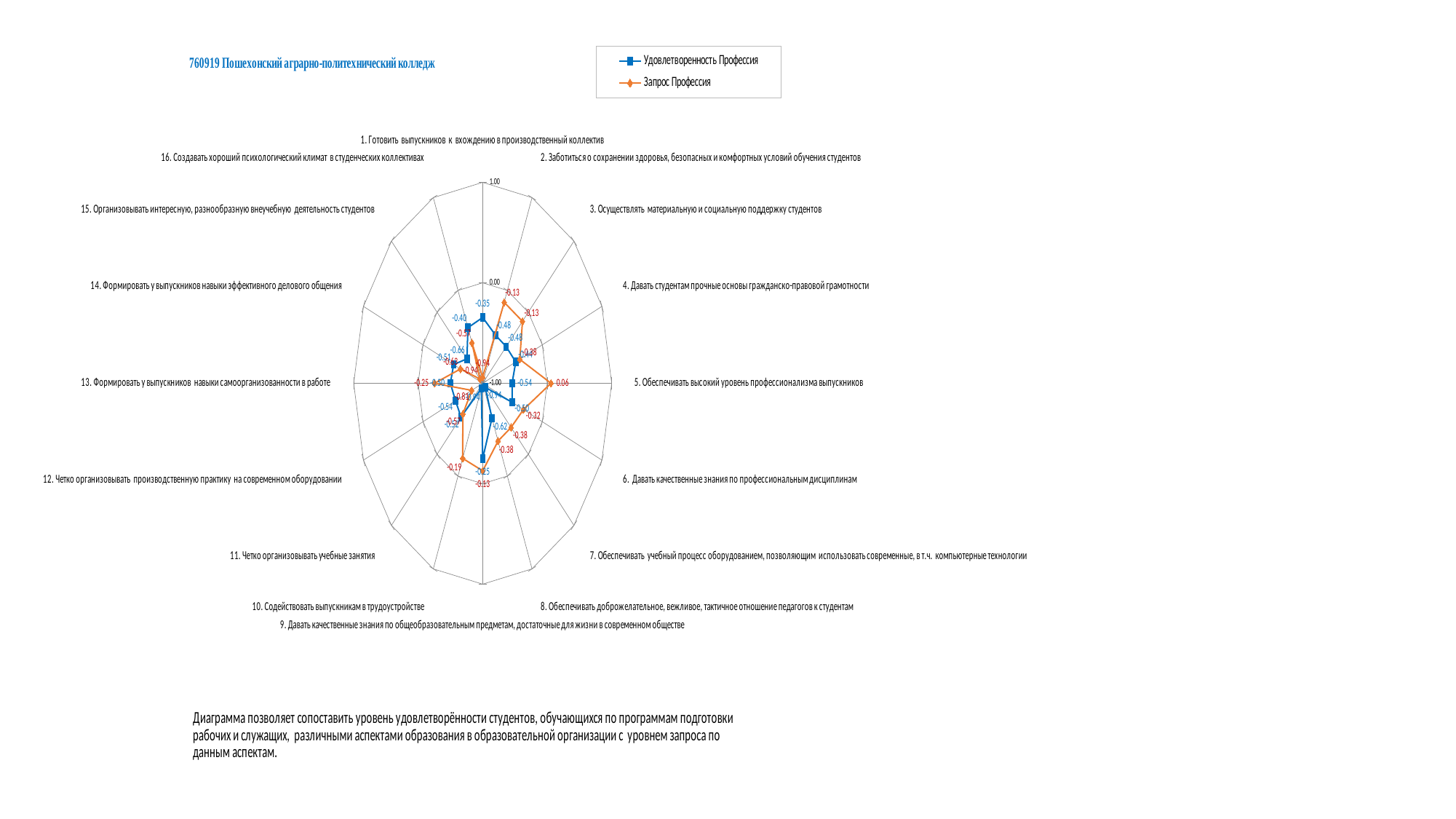
What is the difference between the 'Запрос Профессия' and 'Удовлетворенность Профессия' values for category 5 (Обеспечивать высокий уровень профессионализма выпускников)? 0.60 What kind of chart is shown on the slide? Radar chart For category 5 (Обеспечивать высокий уровень профессионализма выпускников), which series has the larger value: 'Удовлетворенность Профессия' or 'Запрос Профессия'? Запрос Профессия How many series does the legend list? 2 What is the title shown above the chart? 760919 Пошехонский аграрно-политехнический колледж For which category does the 'Запрос Профессия' series reach its highest value? 5. Обеспечивать высокий уровень профессионализма выпускников What is the value of the 'Удовлетворенность Профессия' series for category 1 (Готовить выпускников к вхождению в производственный коллектив)? -0.35 What are the two series named in the legend? Удовлетворенность Профессия; Запрос Профессия What is the value of the 'Удовлетворенность Профессия' series for category 5 (Обеспечивать высокий уровень профессионализма выпускников)? -0.54 What is the value of the 'Запрос Профессия' series for category 5 (Обеспечивать высокий уровень профессионализма выпускников)? 0.06 What is the value of the 'Запрос Профессия' series for category 1 (Готовить выпускников к вхождению в производственный коллектив)? -0.94 How many categories (axes) does the radar chart have? 16